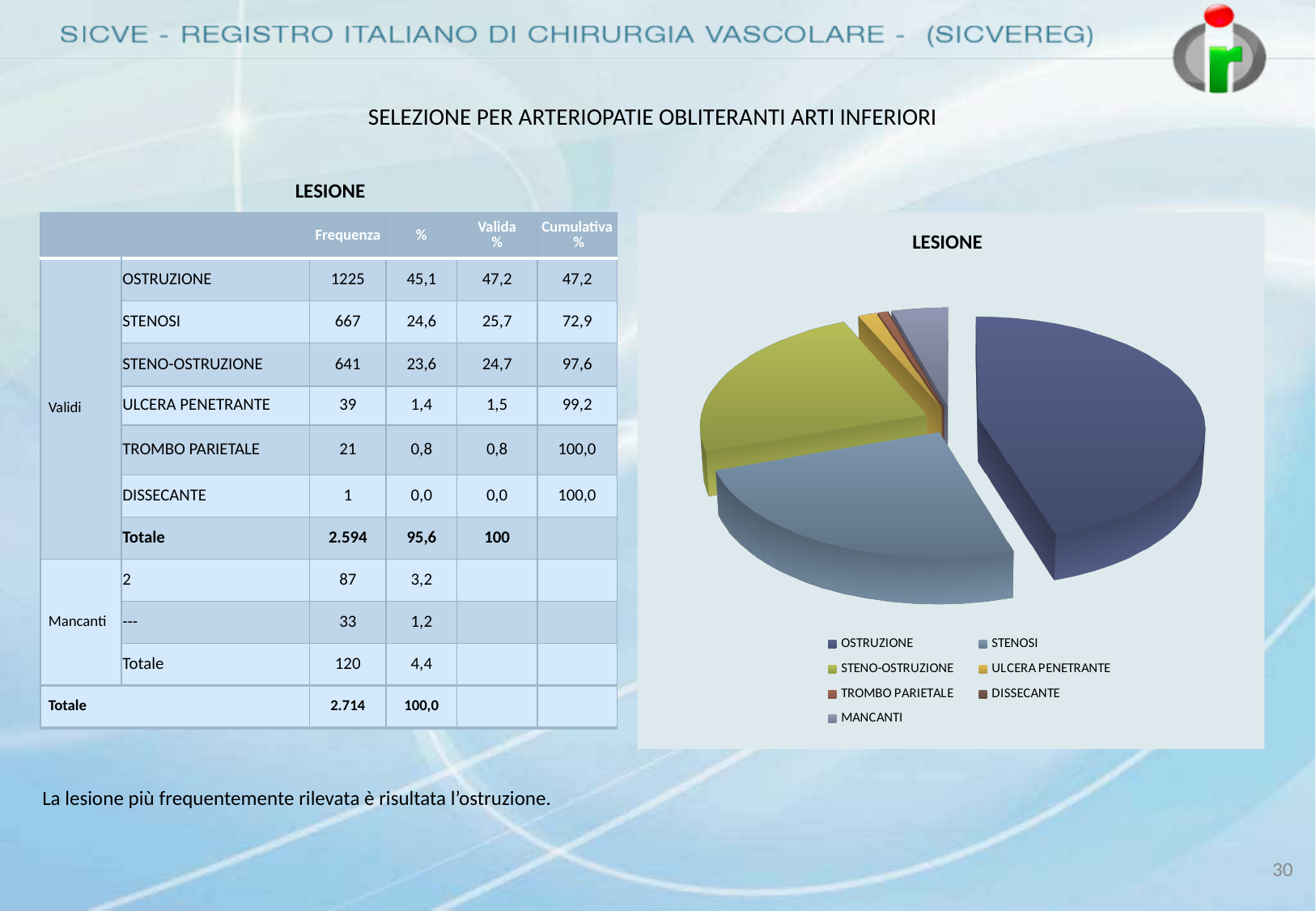
How many categories does the legend of the pie chart list? 7 In the pie chart, which slice is larger: OSTRUZIONE or STENOSI? OSTRUZIONE Which category has the largest slice in the pie chart? OSTRUZIONE According to the table on the slide, what is the frequency (Frequenza) of STENO-OSTRUZIONE? 641 What kind of chart is shown on the slide? pie chart What colour is the OSTRUZIONE slice in the pie chart? dark blue According to the table on the slide, what is the frequency (Frequenza) of OSTRUZIONE? 1225 According to the table on the slide, what percentage (%) of the total does STENOSI represent? 24,6 According to the table on the slide, what is the difference in frequency between STENOSI and STENO-OSTRUZIONE? 26 In the pie chart, which slice is larger: STENO-OSTRUZIONE or ULCERA PENETRANTE? STENO-OSTRUZIONE What is the title of the pie chart? LESIONE In the pie chart, which slice is larger: STENOSI or TROMBO PARIETALE? STENOSI